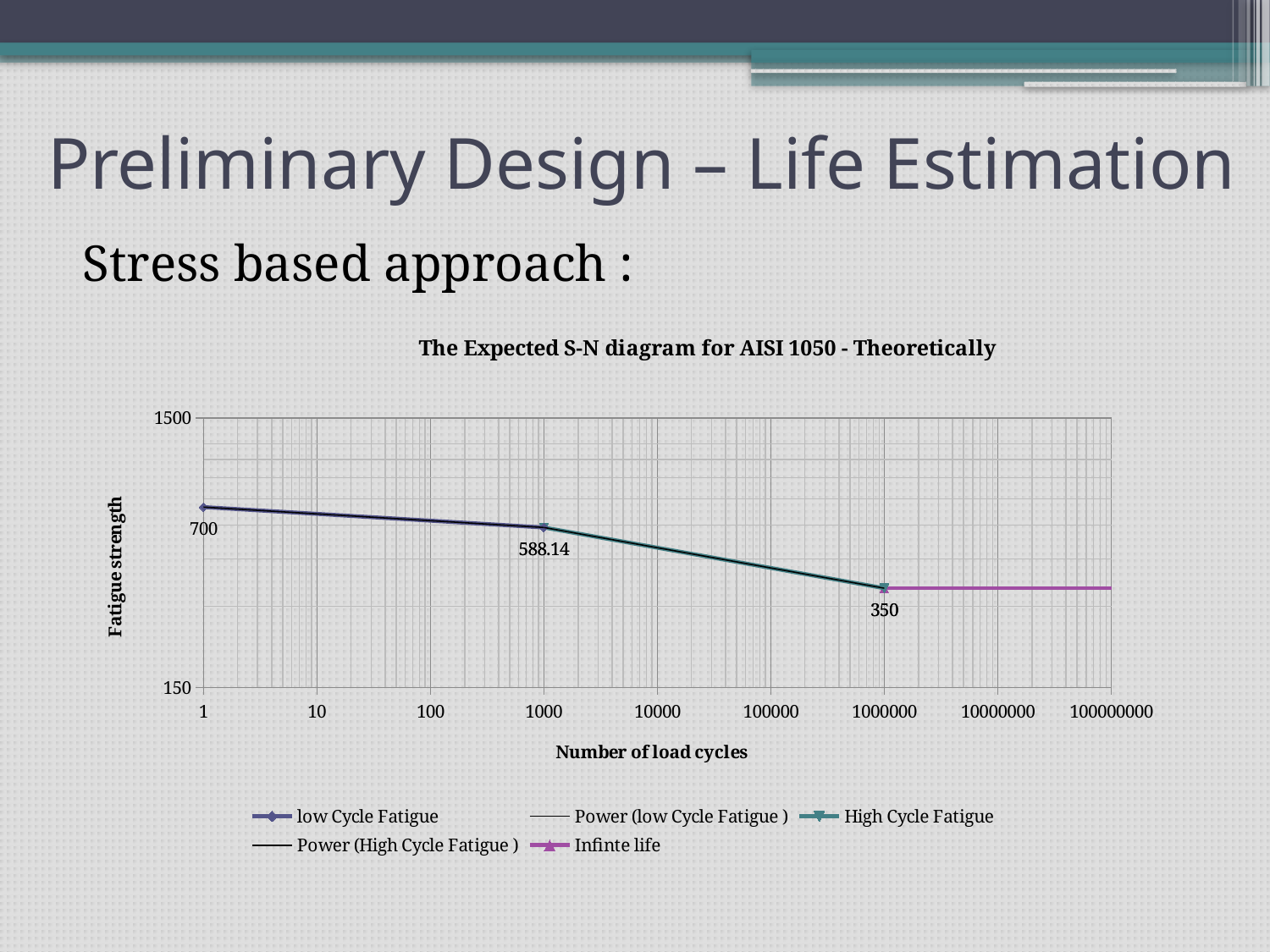
What kind of chart is shown on the slide? line chart What is the fatigue strength at 1 load cycle? 700 What is the title of the chart? The Expected S-N diagram for AISI 1050 - Theoretically At which number of load cycles is the labelled fatigue strength highest? 1 How many series does the legend list? 5 What is the label of the x axis? Number of load cycles What is the fatigue strength at 1000 load cycles? 588.14 What is the fatigue strength at 1000000 load cycles? 350 What is the difference between the fatigue strength at 1 cycle and at 1000000 cycles? 350 Which is larger, the fatigue strength at 1000 cycles or at 1000000 cycles? 1000 cycles Does the fatigue strength rise or fall as the number of load cycles increases from 1 to 1000000? fall What is the difference between the fatigue strength at 1 cycle and at 1000 cycles? 111.86